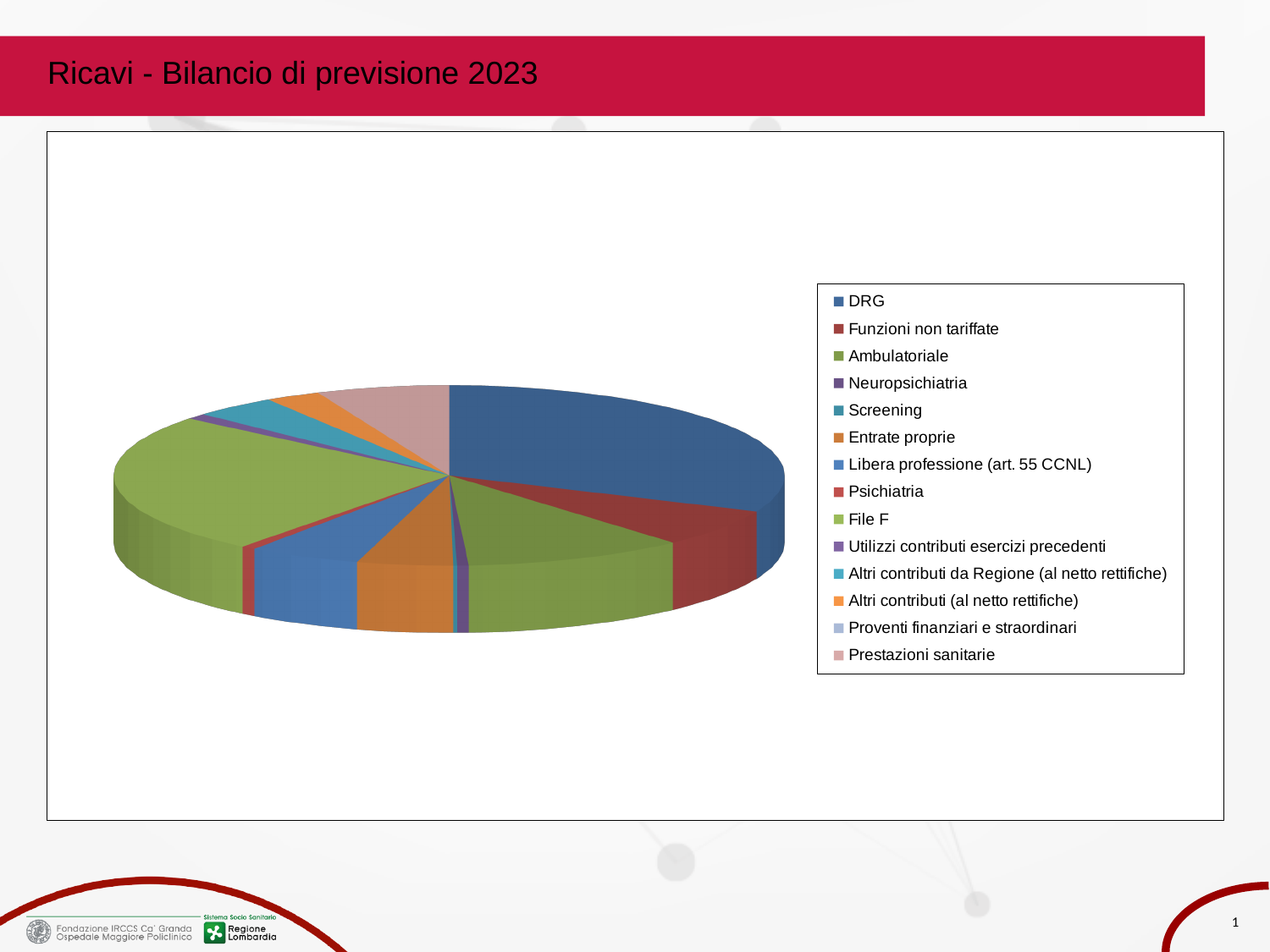
Which is the first category listed in the legend of the pie chart? DRG Which slice is larger, Ambulatoriale or Neuropsichiatria? Ambulatoriale Which slice is larger, File F or Psichiatria? File F How many categories does the legend of the pie chart list? 14 Which slice is larger, DRG or Screening? DRG What kind of chart is shown on the slide? pie chart What is the title of the slide containing the pie chart? Ricavi - Bilancio di previsione 2023